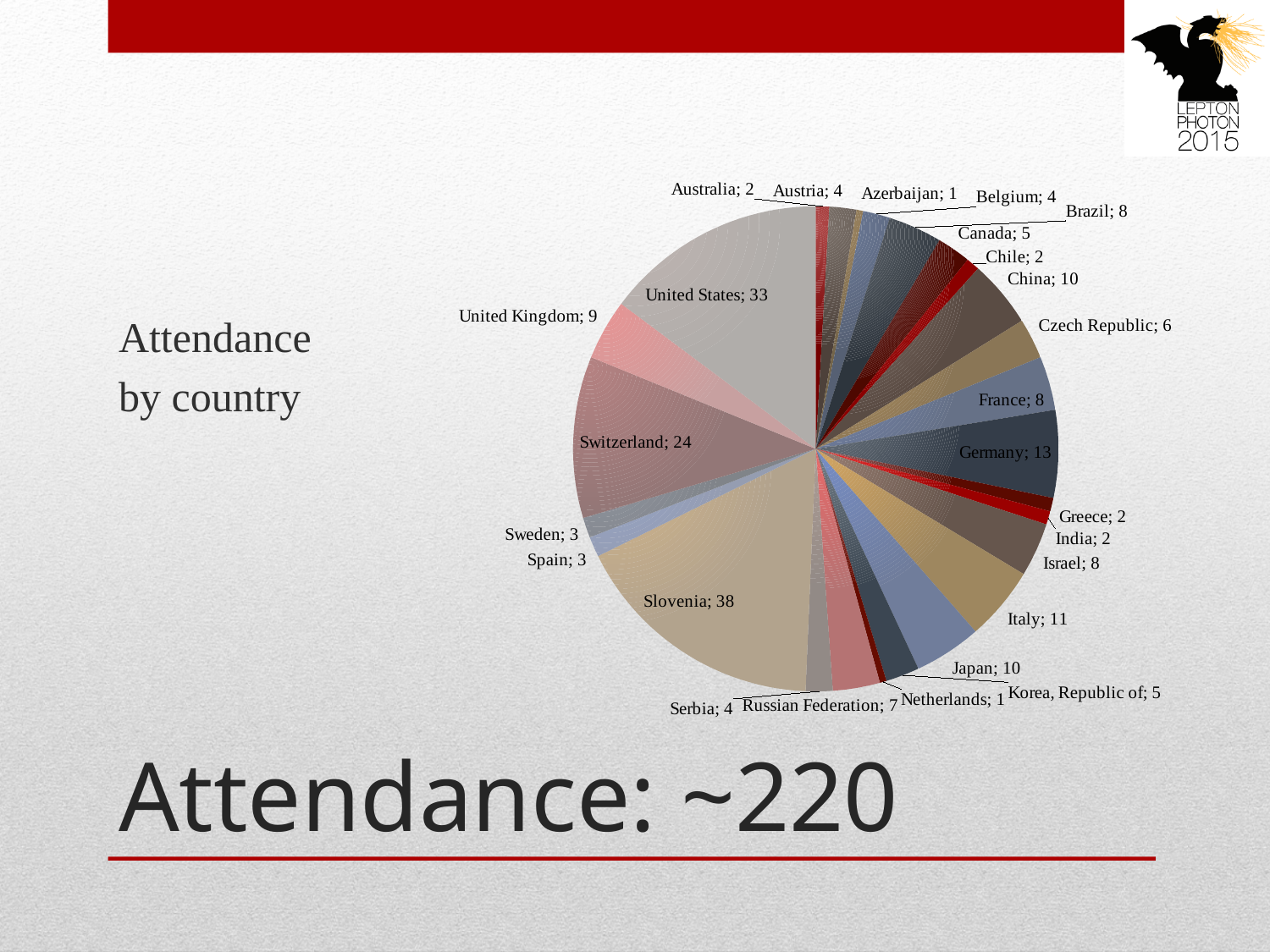
What is the attendance value for the Russian Federation? 7 Which has a larger value, Switzerland or the United Kingdom? Switzerland What is the difference between the values for Italy and Japan? 1 How many countries are shown in the pie chart? 26 What is the difference between the values for Slovenia and the United States? 5 What kind of chart is shown on the slide? pie chart What is the attendance value for Slovenia? 38 What is the attendance value for Germany? 13 Which has a larger value, China or Czech Republic? China What is the title text shown to the left of the pie chart? Attendance by country What is the attendance value for Switzerland? 24 Which country has the largest slice in the pie chart? Slovenia